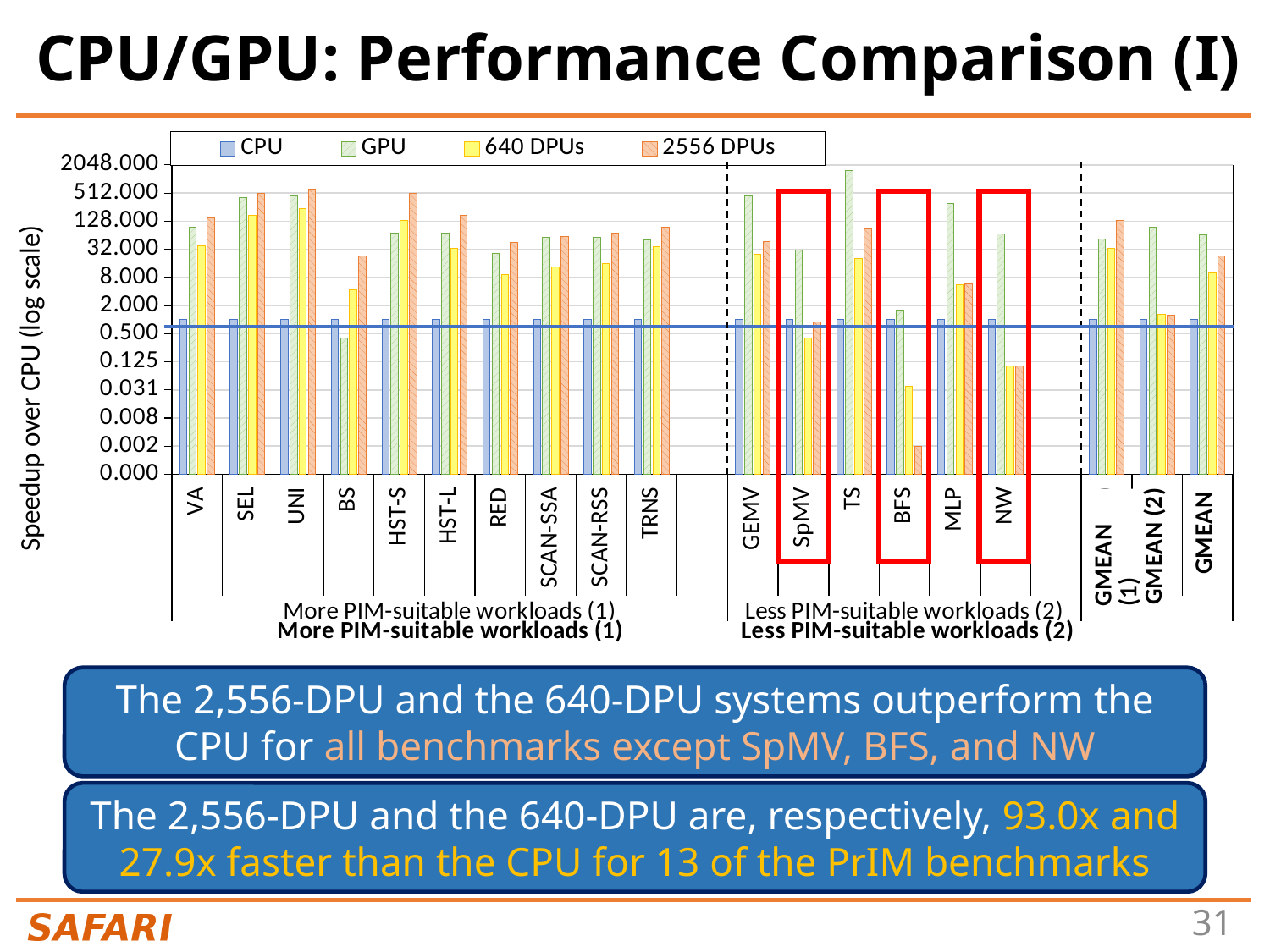
For MLP, which is larger: the GPU value or the 2556 DPUs value? GPU Is the GPU value for TS greater or less than 512.000? greater Is the 640 DPUs value for NW greater or less than 0.500? less How many series does the legend list? 4 What kind of chart is shown on the slide? bar chart Which benchmark has the highest GPU speedup? TS Is the 2556 DPUs value for BFS greater or less than 0.031? less How many benchmark categories (including the GMEAN entries) are shown along the x axis? 19 Which benchmark has the lowest 2556 DPUs speedup? BFS What is the label of the y axis? Speedup over CPU (log scale) For HST-S, which is larger: the GPU value or the 2556 DPUs value? 2556 DPUs